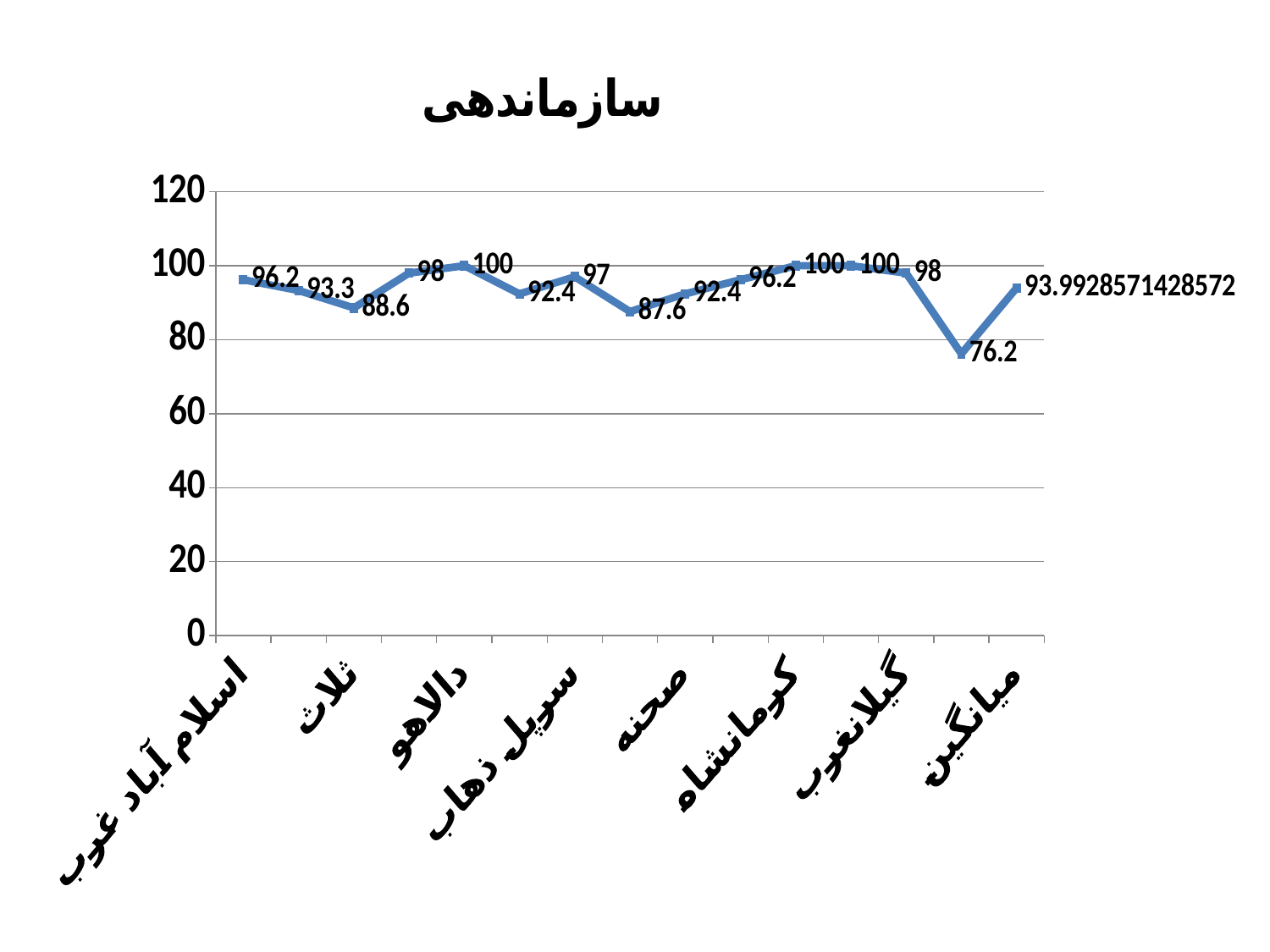
What is the value for اسلام آباد غرب? 96.2 Is the value for میانگین greater or less than 80? greater What type of chart is shown on the slide? line chart What is the value for ثلاث? 88.6 What is the title of the chart? سازماندهی What is the difference between the highest value (100) and the lowest value (76.2)? 23.8 How many data points are plotted on the line? 15 What is the highest value plotted on the chart? 100 What is the value for گیلانغرب? 98 What is the value for میانگین? 93.9928571428572 Which is larger, the value for اسلام آباد غرب or the value for ثلاث? اسلام آباد غرب What is the lowest value plotted on the chart? 76.2